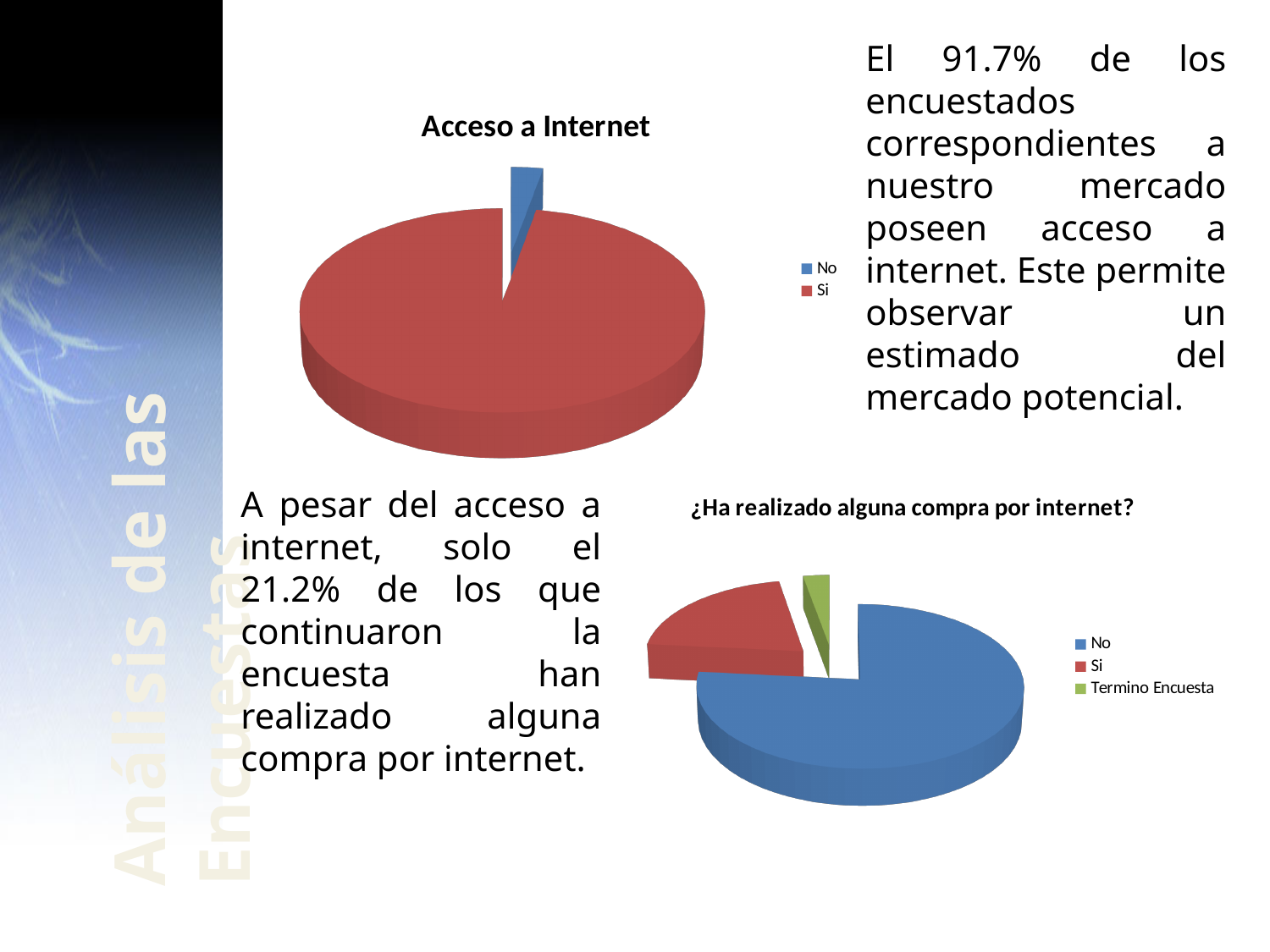
What kind of chart is the "Acceso a Internet" chart? Pie chart How many categories does the legend of the "¿Ha realizado alguna compra por internet?" chart list? 3 What kind of chart is the "¿Ha realizado alguna compra por internet?" chart? Pie chart How many categories does the legend of the "Acceso a Internet" chart list? 2 In the "¿Ha realizado alguna compra por internet?" chart, which category has the largest slice? No In the "¿Ha realizado alguna compra por internet?" chart, which category has the smallest slice? Termino Encuesta In the "Acceso a Internet" chart, which category has the largest slice? Si In the "Acceso a Internet" chart, which slice is larger, "Si" or "No"? Si In the "¿Ha realizado alguna compra por internet?" chart, which slice is larger, "Si" or "Termino Encuesta"? Si In the "Acceso a Internet" chart, which category has the smallest slice? No What colour is the "Si" slice in the "Acceso a Internet" chart? Red What is the title of the lower pie chart on the slide? ¿Ha realizado alguna compra por internet?